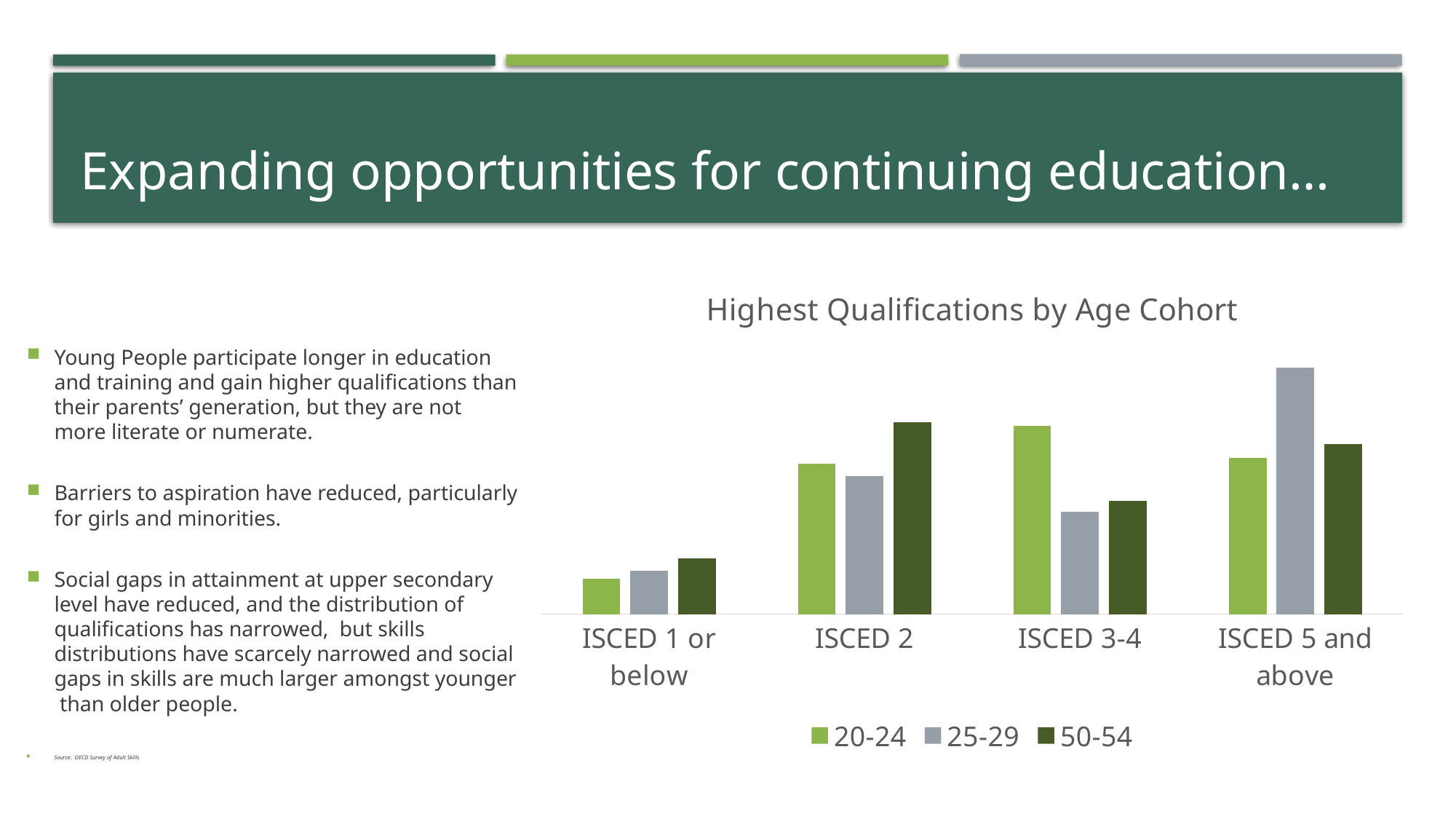
What kind of chart is shown on the slide? Bar chart Which age cohort has the tallest bar anywhere in the chart? 25-29 Which age cohorts are listed in the chart's legend? 20-24, 25-29, 50-54 In the ISCED 3-4 category, which age cohort has the highest bar? 20-24 For the 25-29 series, which category has the highest bar? ISCED 5 and above For the 50-54 series, which category has the lowest bar? ISCED 1 or below How many series does the legend of the chart list? 3 In the ISCED 2 category, which is larger: the 20-24 bar or the 50-54 bar? 50-54 For the 20-24 series, which category has the lowest bar? ISCED 1 or below How many qualification categories are shown on the x axis of the chart? 4 In the ISCED 3-4 category, which is larger: the 20-24 bar or the 25-29 bar? 20-24 What is the title of the chart? Highest Qualifications by Age Cohort